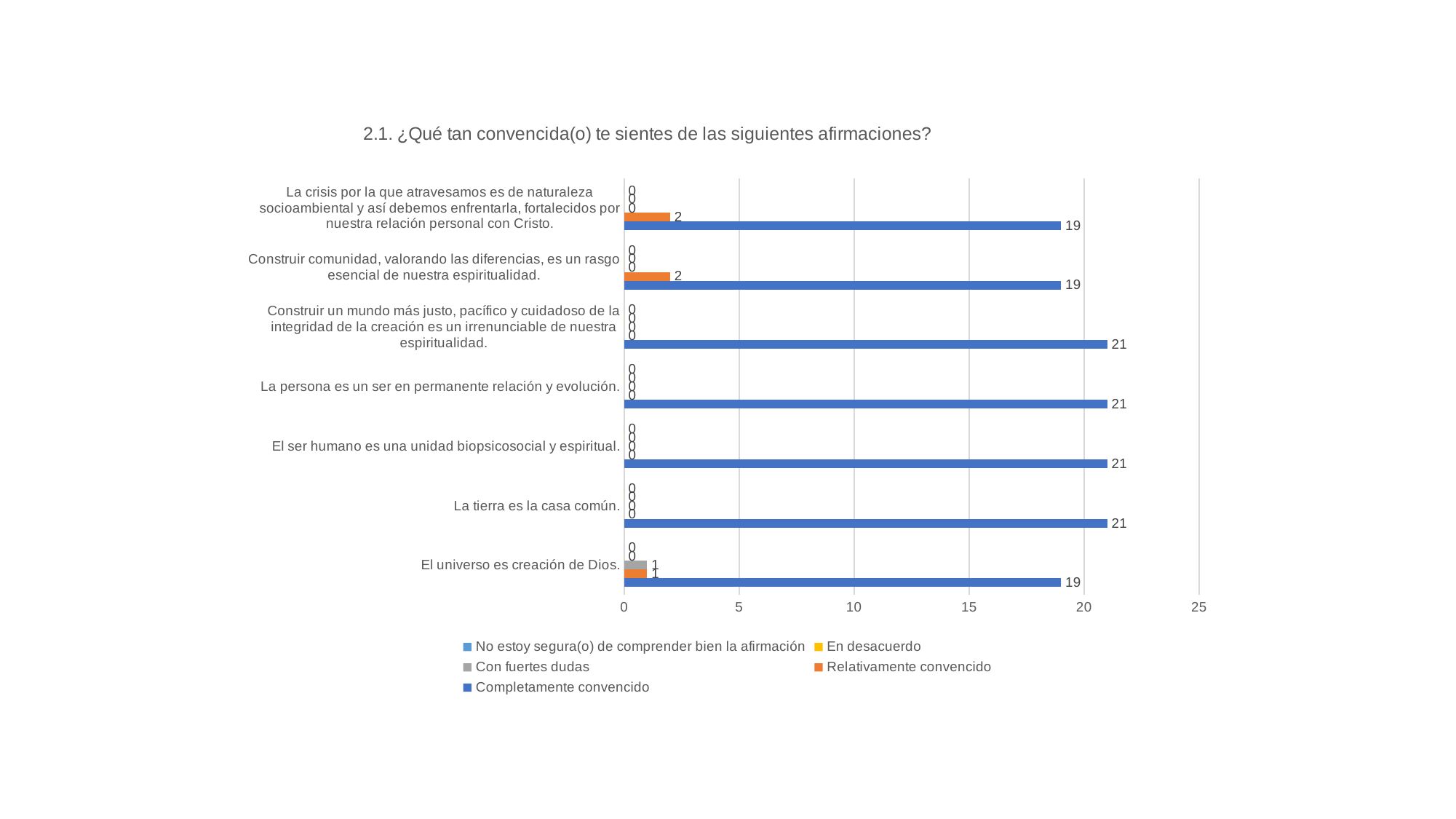
What is the title of the chart? 2.1. ¿Qué tan convencida(o) te sientes de las siguientes afirmaciones? What is the 'Relativamente convencido' value for 'La persona es un ser en permanente relación y evolución.'? 0 How many statements (categories) are plotted on the chart? 7 Which is larger: the 'Completamente convencido' value for 'El ser humano es una unidad biopsicosocial y espiritual.' or for 'Construir comunidad, valorando las diferencias, es un rasgo esencial de nuestra espiritualidad.'? El ser humano es una unidad biopsicosocial y espiritual. What is the total of all series for 'El universo es creación de Dios.'? 21 What is the 'Completamente convencido' value for 'El universo es creación de Dios.'? 19 How many series does the legend list? 5 What kind of chart is shown on the slide? bar chart What is the difference between the 'Completamente convencido' values for 'La tierra es la casa común.' and 'El universo es creación de Dios.'? 2 What is the 'Con fuertes dudas' value for 'El universo es creación de Dios.'? 1 What is the 'Relativamente convencido' value for 'Construir comunidad, valorando las diferencias, es un rasgo esencial de nuestra espiritualidad.'? 2 What is the 'Completamente convencido' value for 'La tierra es la casa común.'? 21